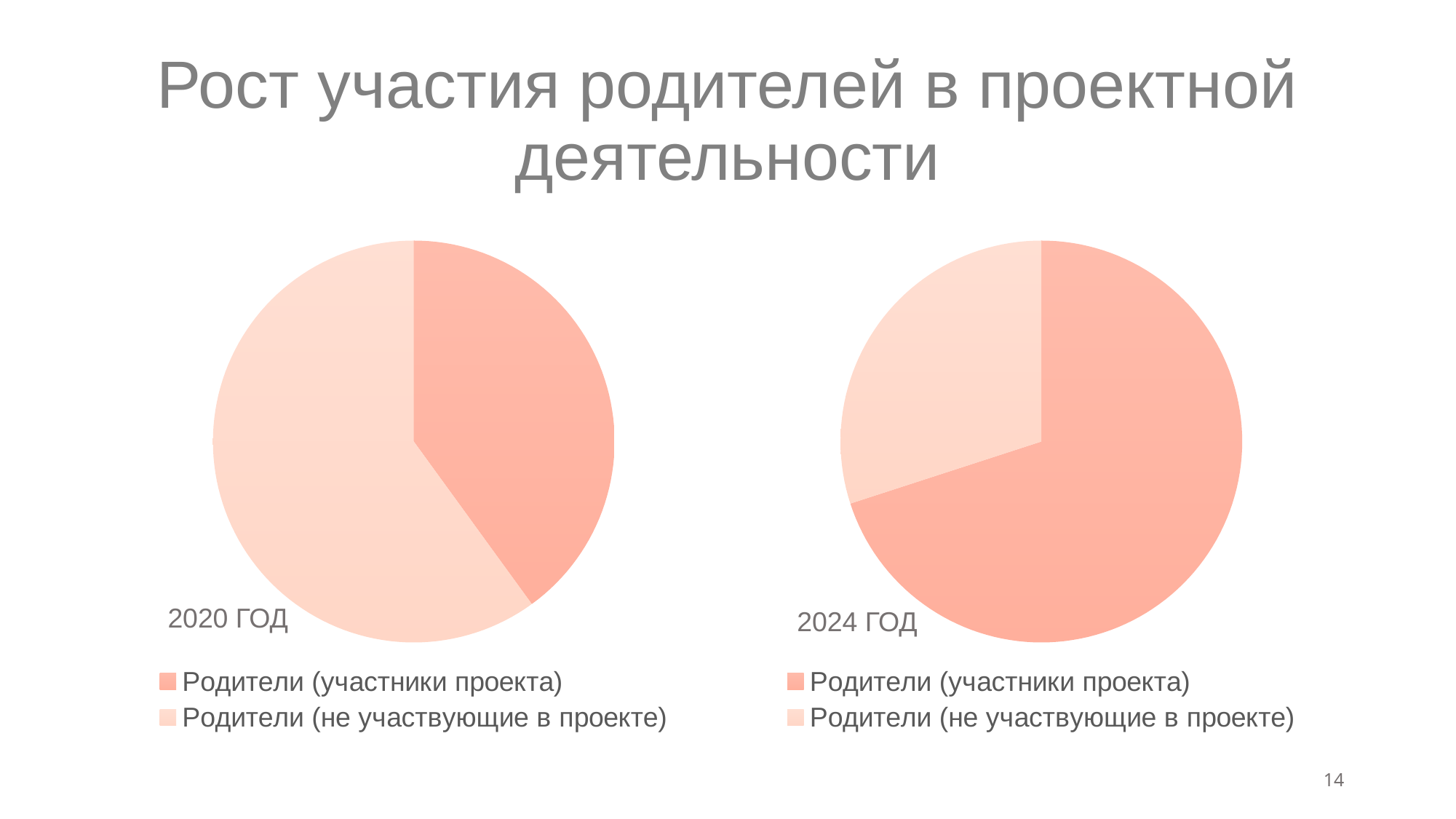
How many entries does the legend of the "2020 ГОД" chart list? 2 Which legend entry is shown in the darker salmon colour in the "2024 ГОД" chart? Родители (участники проекта) How many slices does the "2020 ГОД" pie chart have? 2 In the "2024 ГОД" pie chart, which slice is larger: "Родители (участники проекта)" or "Родители (не участвующие в проекте)"? Родители (участники проекта) How many slices does the "2024 ГОД" pie chart have? 2 In the "2020 ГОД" pie chart, which category has the largest slice? Родители (не участвующие в проекте) In the "2024 ГОД" pie chart, which category has the smallest slice? Родители (не участвующие в проекте) What is the title of the slide containing the two pie charts? Рост участия родителей в проектной деятельности In the "2020 ГОД" pie chart, which slice is larger: "Родители (участники проекта)" or "Родители (не участвующие в проекте)"? Родители (не участвующие в проекте) How many pie charts are shown on the slide? 2 What kind of chart is the "2024 ГОД" chart? pie chart What kind of chart is the "2020 ГОД" chart? pie chart